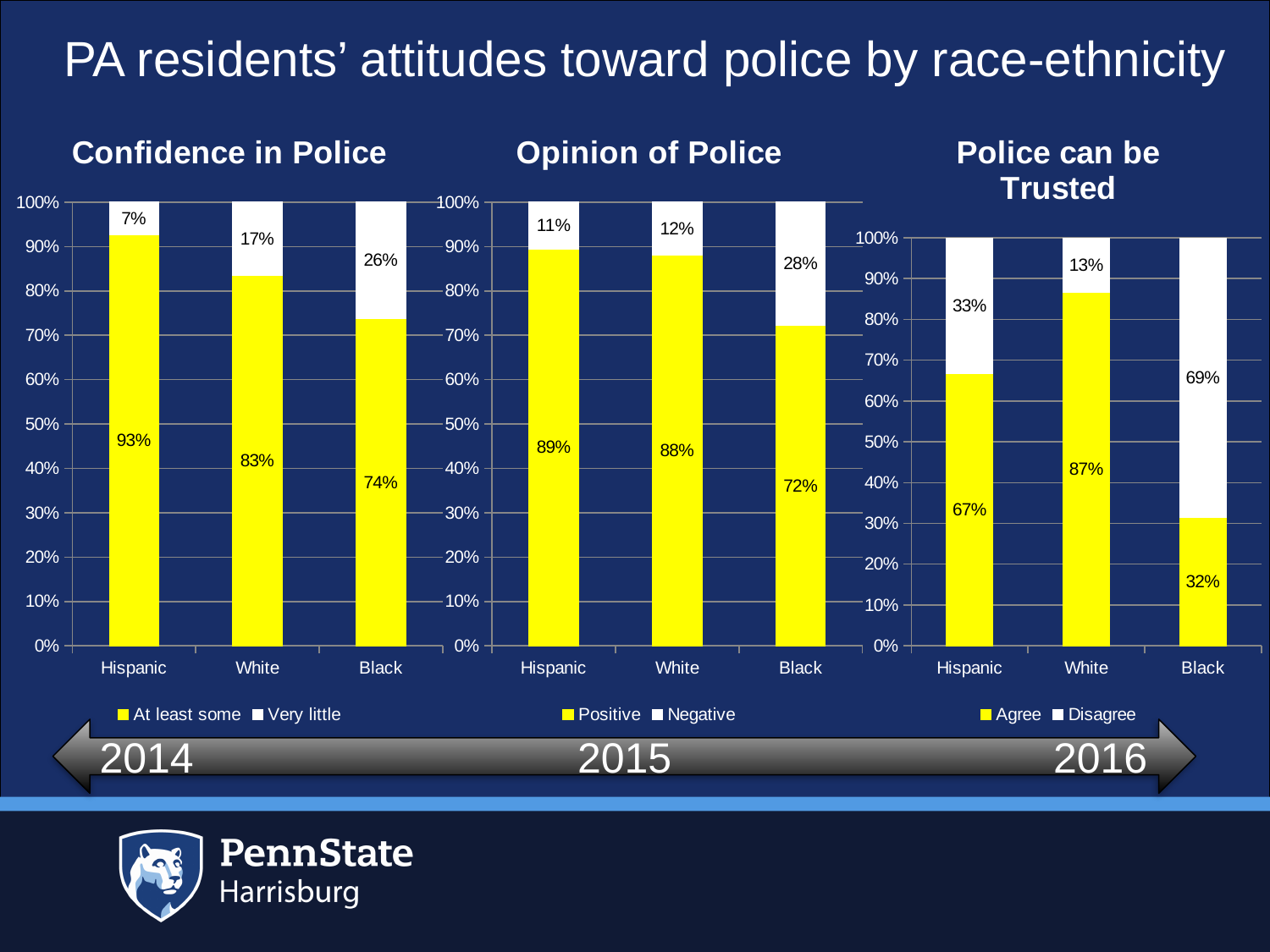
In the 'Police can be Trusted' chart, which group has the highest 'Agree' value? White In the 'Opinion of Police' chart, what is the difference between the 'Negative' values for Black and Hispanic residents? 17% In the 'Opinion of Police' chart, what is the 'Positive' value for White residents? 88% In the 'Confidence in Police' chart, what is the 'Very little' value for Black residents? 26% How many groups are shown on the x axis of the 'Opinion of Police' chart? 3 In the 'Police can be Trusted' chart, what is the 'Disagree' value for Black residents? 69% Which year is shown beneath the 'Opinion of Police' chart? 2015 In the 'Police can be Trusted' chart, is the 'Agree' value larger for Hispanic or Black residents? Hispanic What kind of chart is the 'Police can be Trusted' chart? Stacked bar chart How many series does the legend of the 'Confidence in Police' chart list? 2 In the 'Confidence in Police' chart, which group has the lowest 'At least some' value? Black In the 'Confidence in Police' chart, what is the 'At least some' value for Hispanic residents? 93%